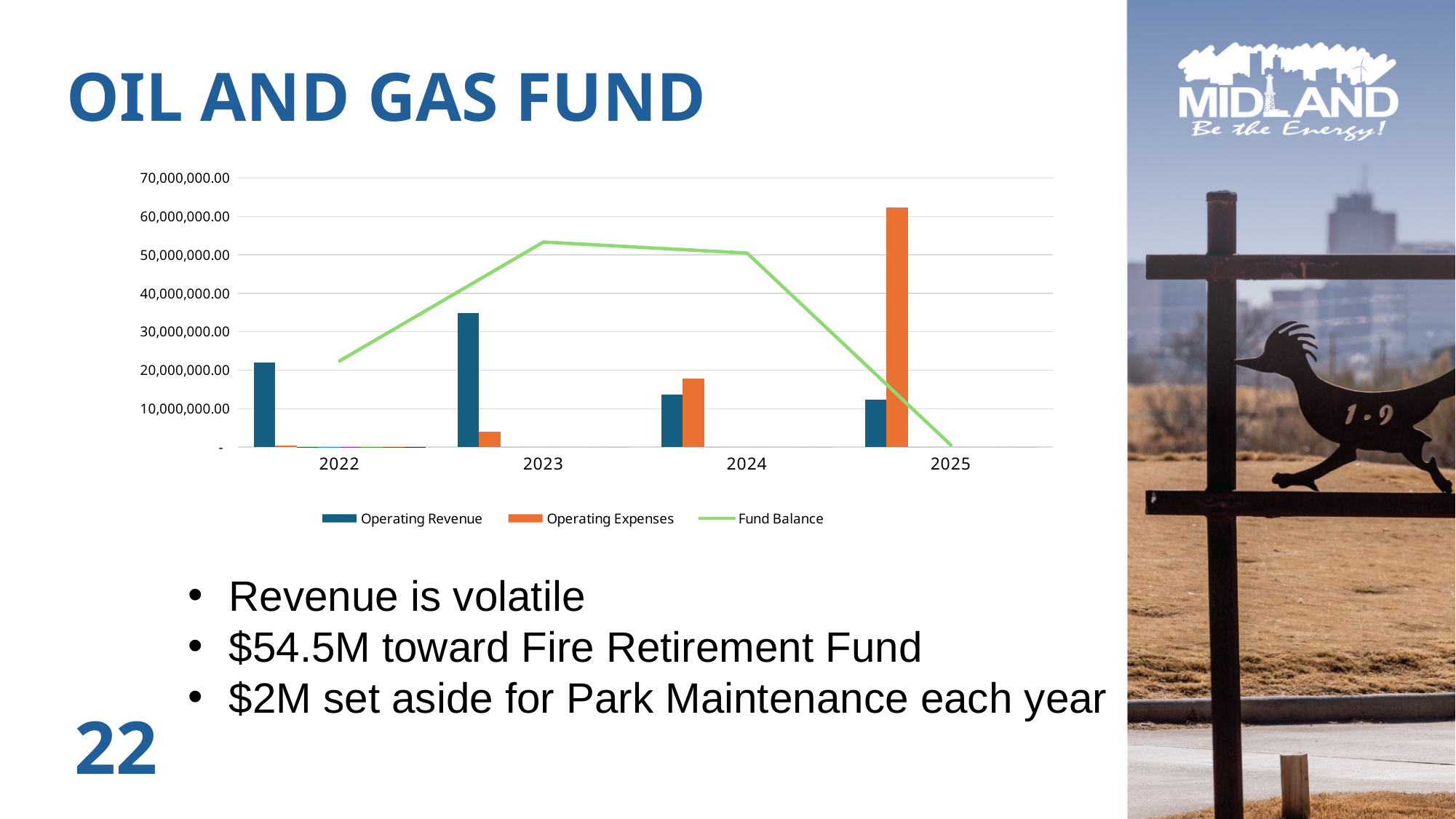
How many years are shown on the x axis of the chart? 4 In which year is Operating Expenses highest? 2025 Does the Fund Balance line rise or fall from 2024 to 2025? Fall Is the Fund Balance value for 2023 greater or less than 50,000,000.00? greater Which series is drawn as a green line in the chart? Fund Balance In which year is Operating Revenue highest? 2023 Is the Operating Expenses value for 2025 greater or less than 60,000,000.00? greater How many series does the chart legend list? 3 In which year is Operating Expenses lowest? 2022 In 2025, which is larger: Operating Revenue or Operating Expenses? Operating Expenses Is the Operating Revenue value for 2023 greater or less than 30,000,000.00? greater What kind of chart is shown on the slide? A combined bar and line chart